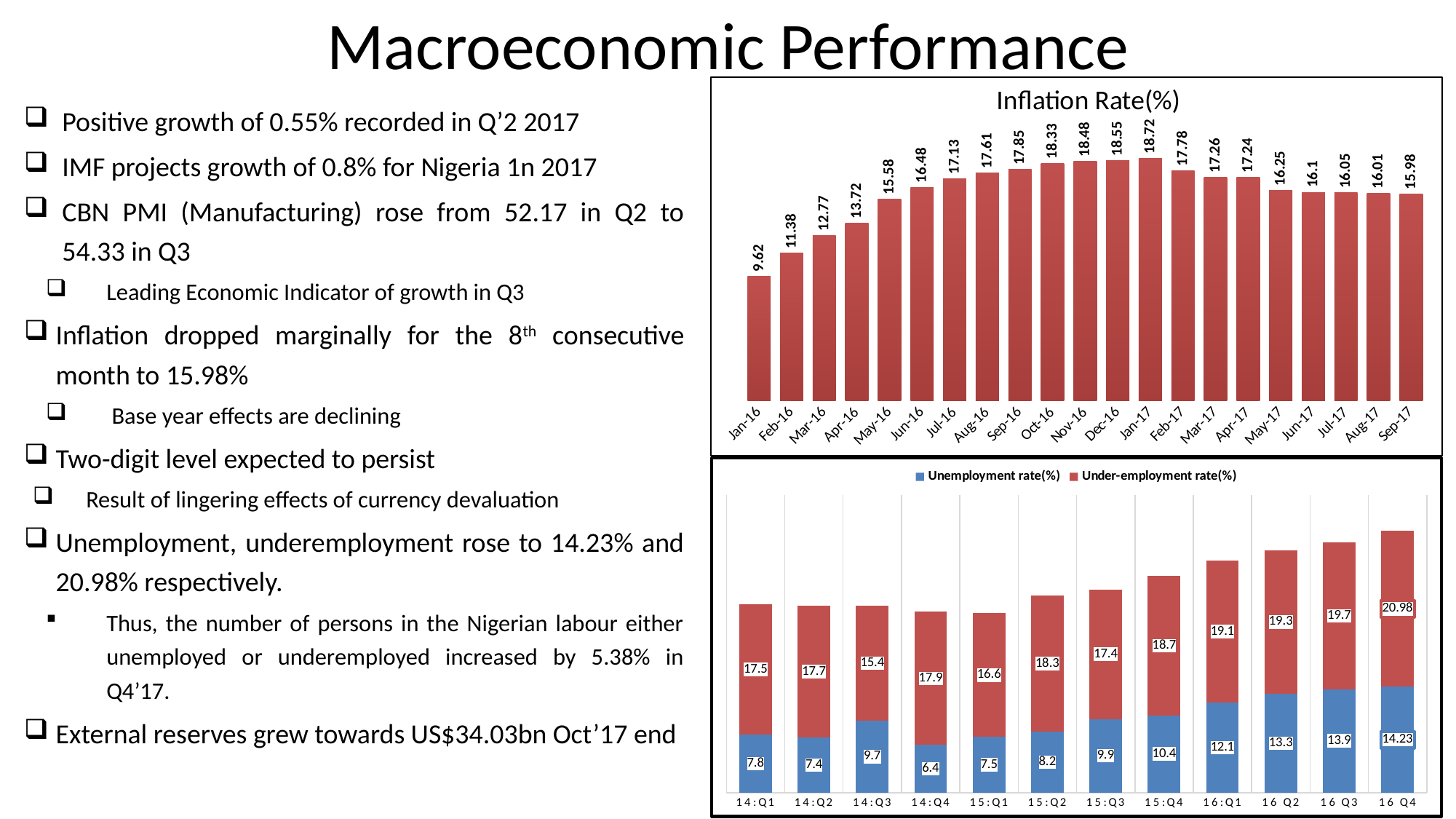
In the bottom-right stacked bar chart, what is the combined total of the Unemployment rate(%) and Under-employment rate(%) for 16 Q4? 35.21 In the Inflation Rate(%) chart, what is the inflation rate for Sep-17? 15.98 In the Inflation Rate(%) chart, what is the difference between the inflation rate in Jan-17 and in Sep-17? 2.74 In the Inflation Rate(%) chart, what kind of chart is used? Bar chart In the Inflation Rate(%) chart, which month has the highest inflation rate? Jan-17 In the bottom-right stacked bar chart, which quarter has the lowest Unemployment rate(%)? 14:Q4 In the Inflation Rate(%) chart, which month has the lowest inflation rate? Jan-16 In the bottom-right stacked bar chart, how many series does the legend list? 2 In the bottom-right stacked bar chart, what is the Under-employment rate(%) for 15:Q3? 17.4 In the bottom-right stacked bar chart, what is the Unemployment rate(%) for 16 Q4? 14.23 In the Inflation Rate(%) chart, how many months are plotted? 21 In the Inflation Rate(%) chart, does the inflation rate rise or fall from Jan-17 to Sep-17? Fall